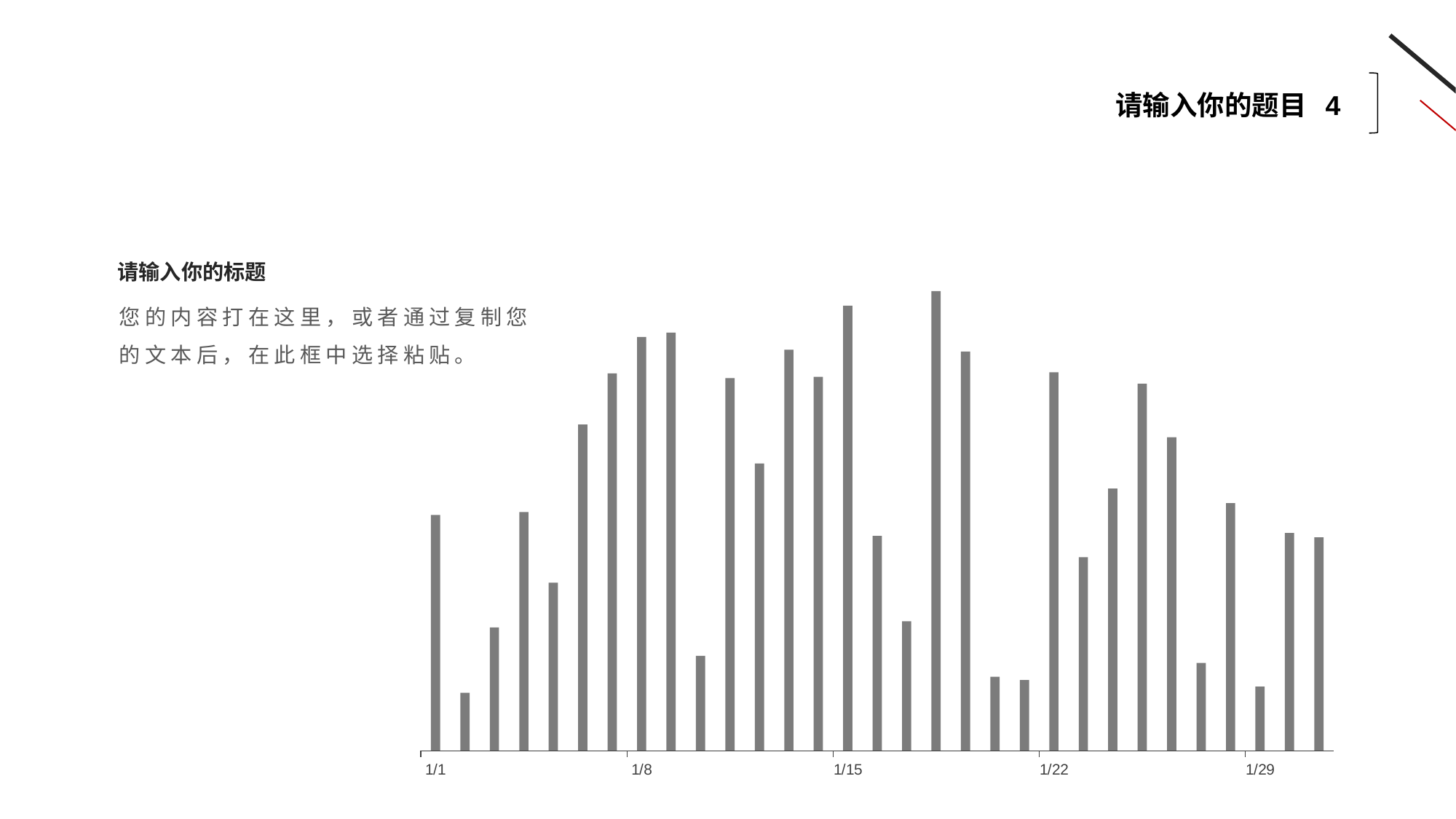
Which of the labeled dates on the x axis has the shortest bar: 1/1, 1/8, 1/15, 1/22 or 1/29? 1/29 What is the first date label shown on the x axis? 1/1 Which bar is taller, the one at 1/29 or the one at 1/1? 1/1 Which of the labeled dates on the x axis has the tallest bar: 1/1, 1/8, 1/15, 1/22 or 1/29? 1/15 How many bars are plotted in the chart? 31 Which bar is taller, the one at 1/8 or the one at 1/22? 1/8 Which bar is taller, the one at 1/1 or the one at 1/15? 1/15 What kind of chart is shown on the slide? bar chart What is the last date label shown on the x axis? 1/29